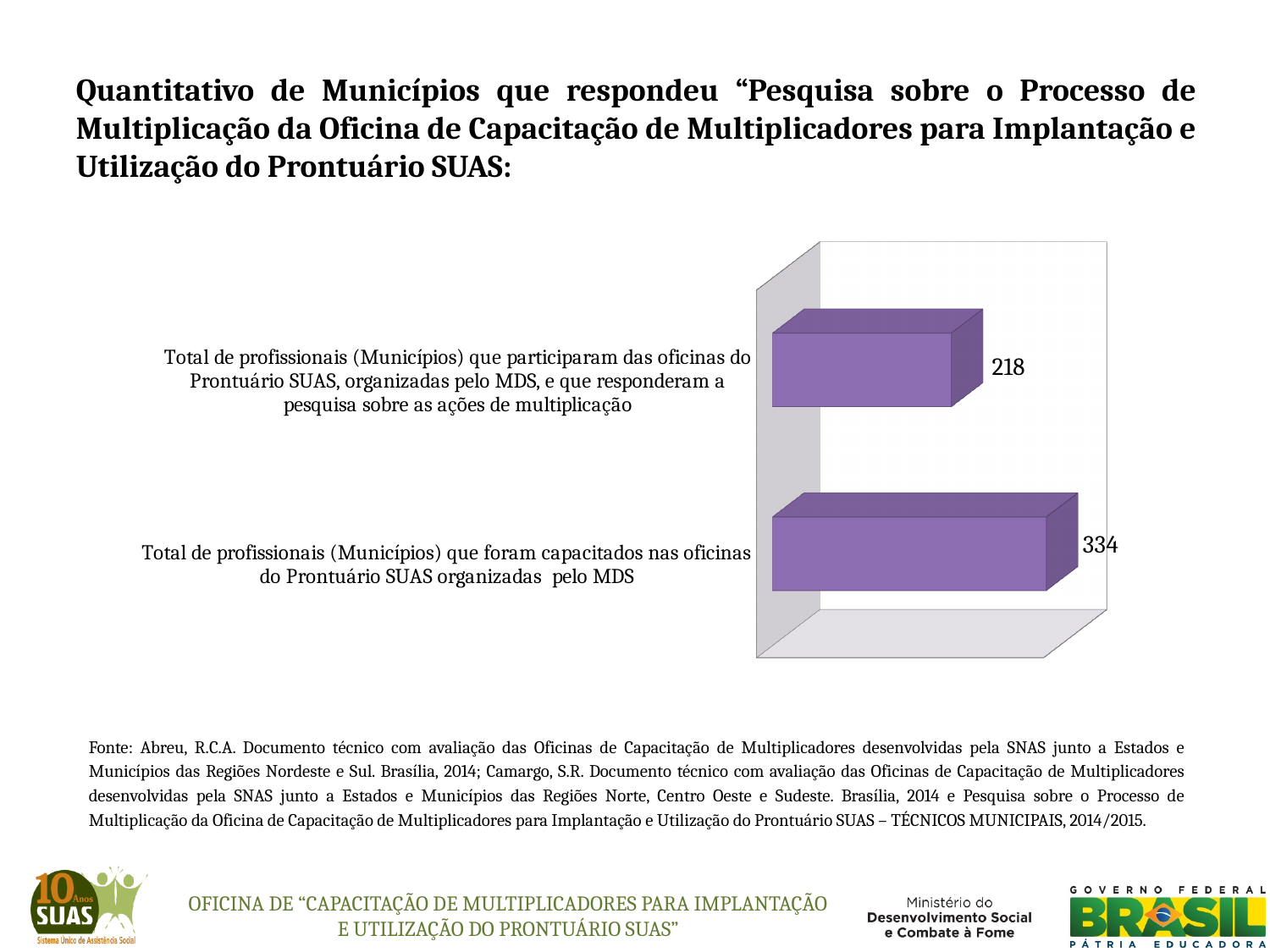
What kind of chart is shown on the slide? Bar chart Which category has the lowest value? Total de profissionais (Municípios) que participaram das oficinas do Prontuário SUAS, organizadas pelo MDS, e que responderam a pesquisa sobre as ações de multiplicação Which is larger: the number of professionals trained in the workshops or the number who responded to the survey? The number trained in the workshops (334) What is the value for the category 'Total de profissionais (Municípios) que foram capacitados nas oficinas do Prontuário SUAS organizadas pelo MDS'? 334 What colour are the bars in the chart? Purple How many categories are plotted in the chart? 2 Are the bars in the chart horizontal or vertical? Horizontal Which category has the highest value? Total de profissionais (Municípios) que foram capacitados nas oficinas do Prontuário SUAS organizadas pelo MDS What is the difference between the number of professionals trained in the workshops (334) and the number who responded to the survey (218)? 116 What is the value for the category 'Total de profissionais (Municípios) que participaram das oficinas do Prontuário SUAS, organizadas pelo MDS, e que responderam a pesquisa sobre as ações de multiplicação'? 218